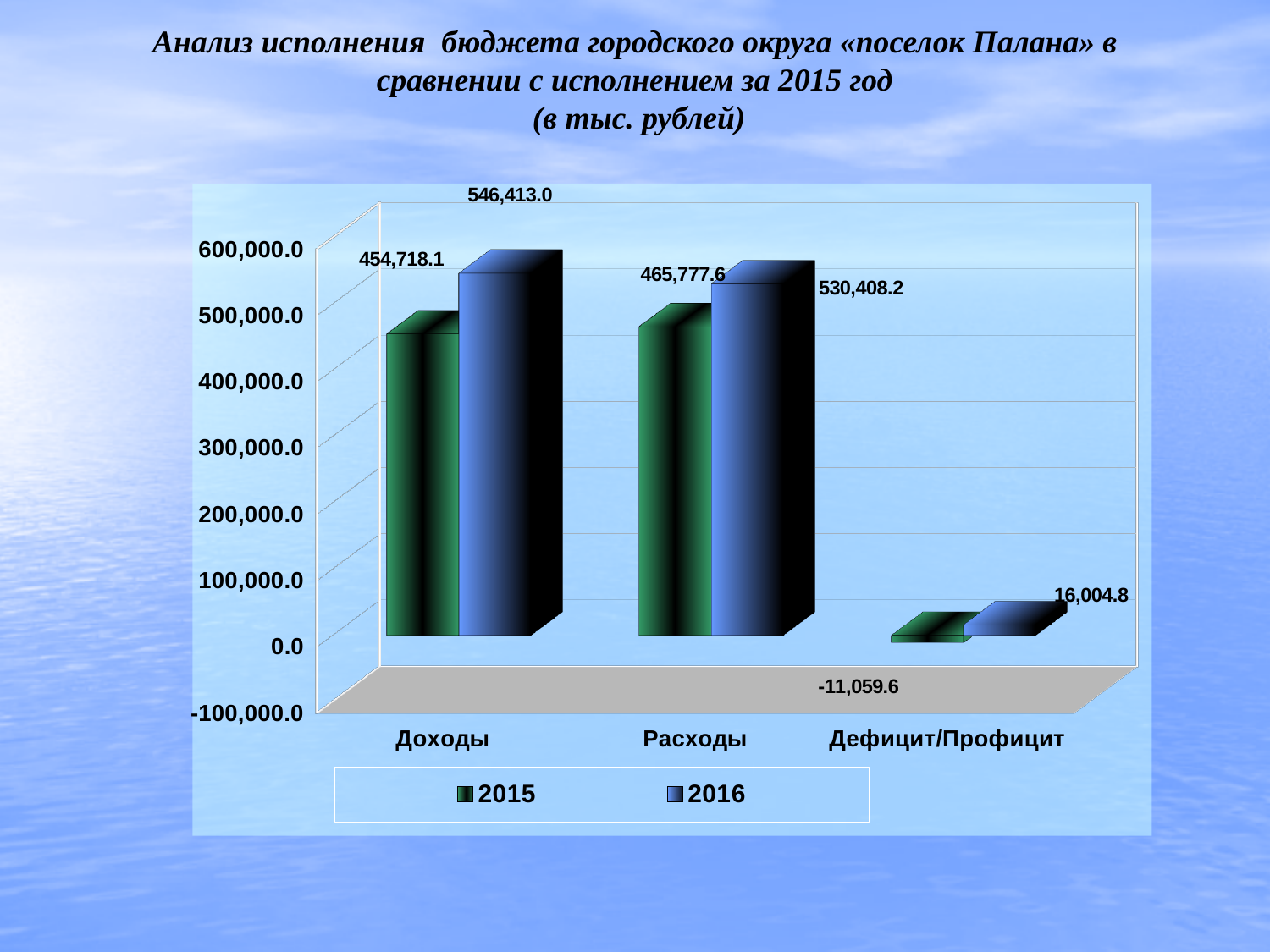
What is the difference between the 2016 and 2015 values for Доходы? 91,694.9 Which category has the highest value in the 2016 series? Доходы Which category has the lowest value in the 2015 series? Дефицит/Профицит What kind of chart is shown on the slide? Bar chart What is the value for Расходы in 2015? 465,777.6 What is the value for Дефицит/Профицит in 2016? 16,004.8 How many categories are shown on the x axis? 3 What is the difference between the 2016 and 2015 values for Расходы? 64,630.6 What is the value for Доходы in 2016? 546,413.0 How many series does the legend list? 2 Which is larger in 2015: Доходы or Расходы? Расходы What is the value for Дефицит/Профицит in 2015? -11,059.6